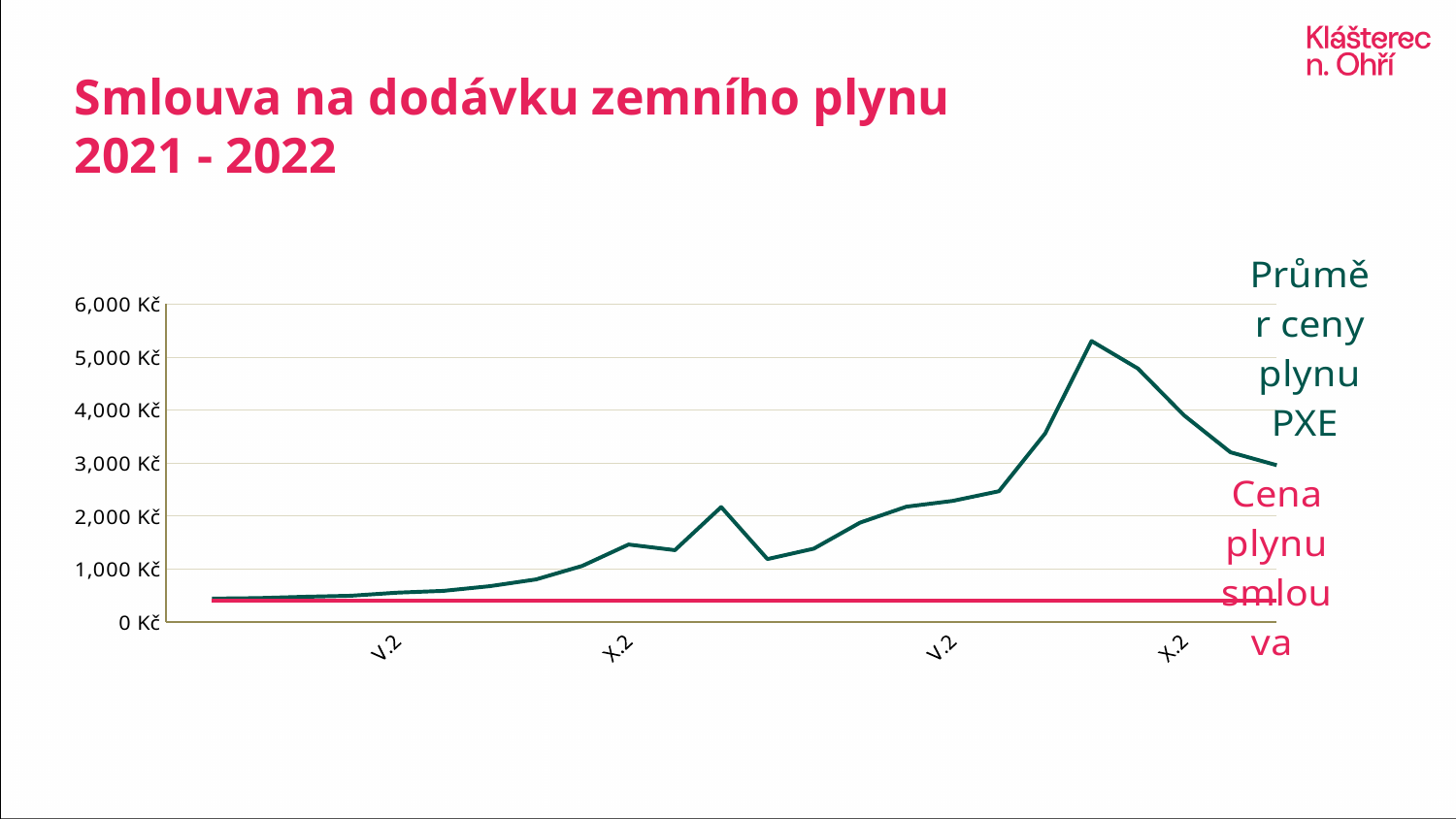
Which series reaches the higher value at the chart's peak, Průměr ceny plynu PXE or Cena plynu smlouva? Průměr ceny plynu PXE What kind of chart is shown on the slide? line chart How many series does the chart's legend list? 2 Does the Cena plynu smlouva line rise, fall or stay flat across the chart? stay flat Is the value of the Průměr ceny plynu PXE line at the right end of the chart greater or less than 2,000 Kč? greater Is the value of the Průměr ceny plynu PXE line at the left end of the chart greater or less than 1,000 Kč? less What colour is the Cena plynu smlouva line? pink What are the two series named in the chart's legend? Průměr ceny plynu PXE and Cena plynu smlouva What is the highest value shown on the chart's vertical axis? 6,000 Kč Does the Průměr ceny plynu PXE line overall rise or fall from the left end of the chart to its peak? rise Is the highest value of the Průměr ceny plynu PXE line greater or less than 5,000 Kč? greater